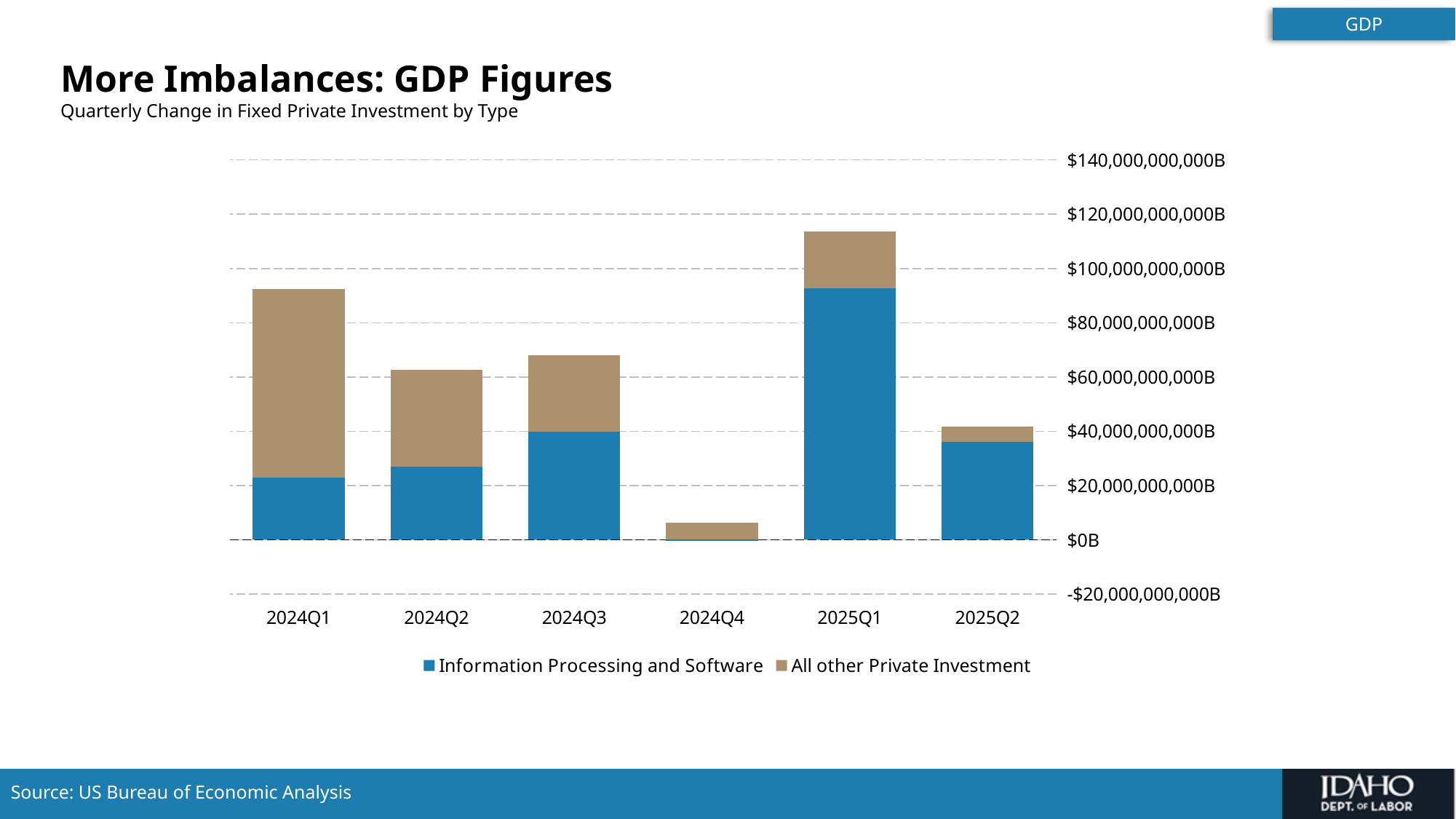
Is the Information Processing and Software value for 2024Q1 greater or less than $40,000,000,000B? less Which quarter has the highest total stacked bar? 2025Q1 What kind of chart is shown on the slide? Bar chart Is the total stacked value for 2025Q1 greater or less than $100,000,000,000B? greater Is the total stacked value for 2024Q4 greater or less than $20,000,000,000B? less How many quarters are shown on the x axis? 6 What are the two series named in the legend? Information Processing and Software; All other Private Investment Which quarter has the largest Information Processing and Software segment? 2025Q1 Which has the larger total stacked bar, 2024Q1 or 2024Q2? 2024Q1 What is the subtitle of the chart? Quarterly Change in Fixed Private Investment by Type How many series does the legend list? 2 Which quarter has the lowest total stacked bar? 2024Q4